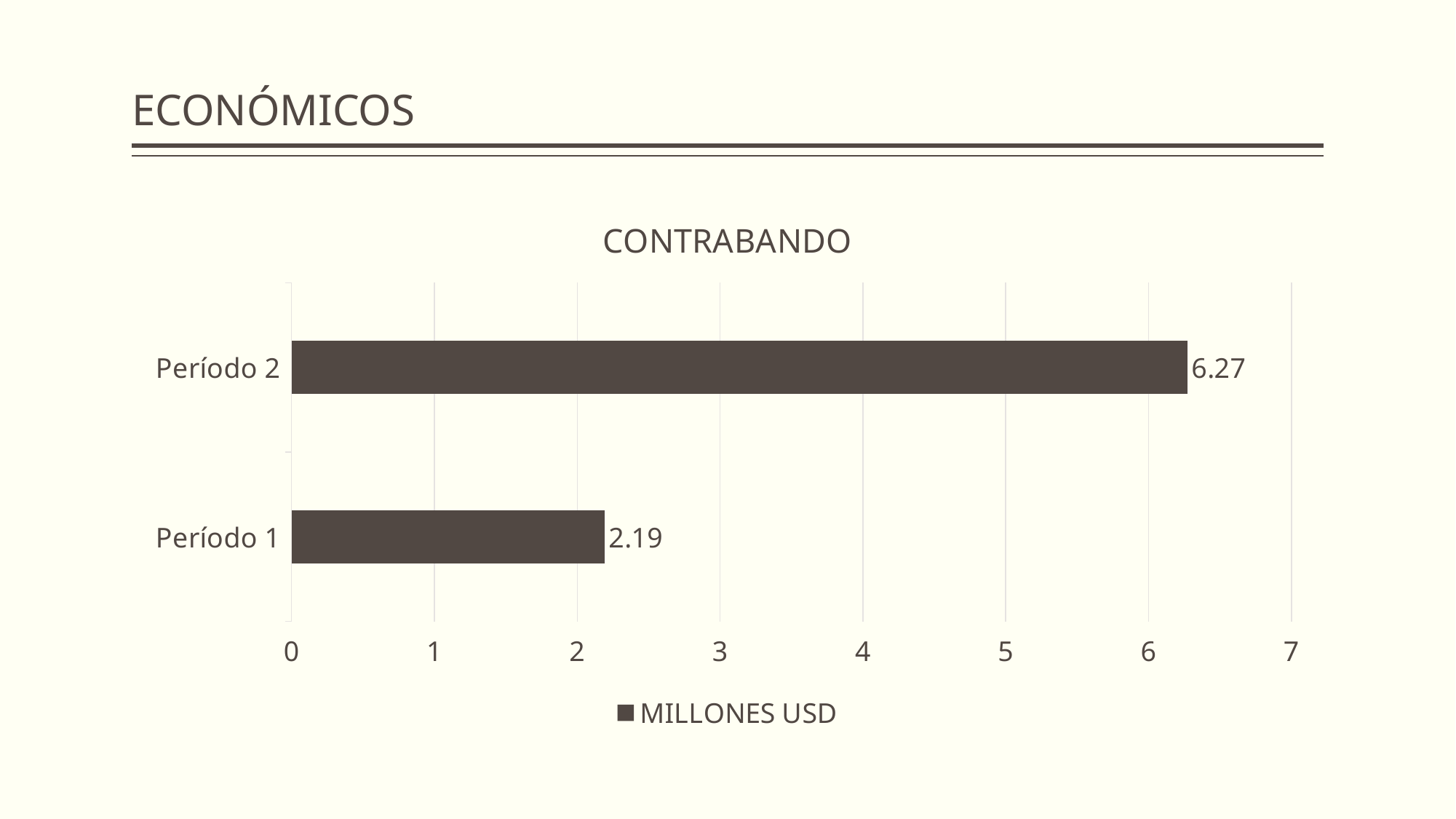
What is the difference between the values for Período 2 and Período 1? 4.08 Is the value for Período 1 greater or less than 3? less What is the title of the chart? CONTRABANDO Which category has the lowest value? Período 1 What is the value for Período 1? 2.19 Is the value for Período 2 greater or less than 6? greater How many series does the legend list? 1 Which is larger, the value for Período 1 or Período 2? Período 2 How many categories are shown in the chart? 2 What kind of chart is shown? Bar chart Which category has the highest value? Período 2 What is the value for Período 2? 6.27